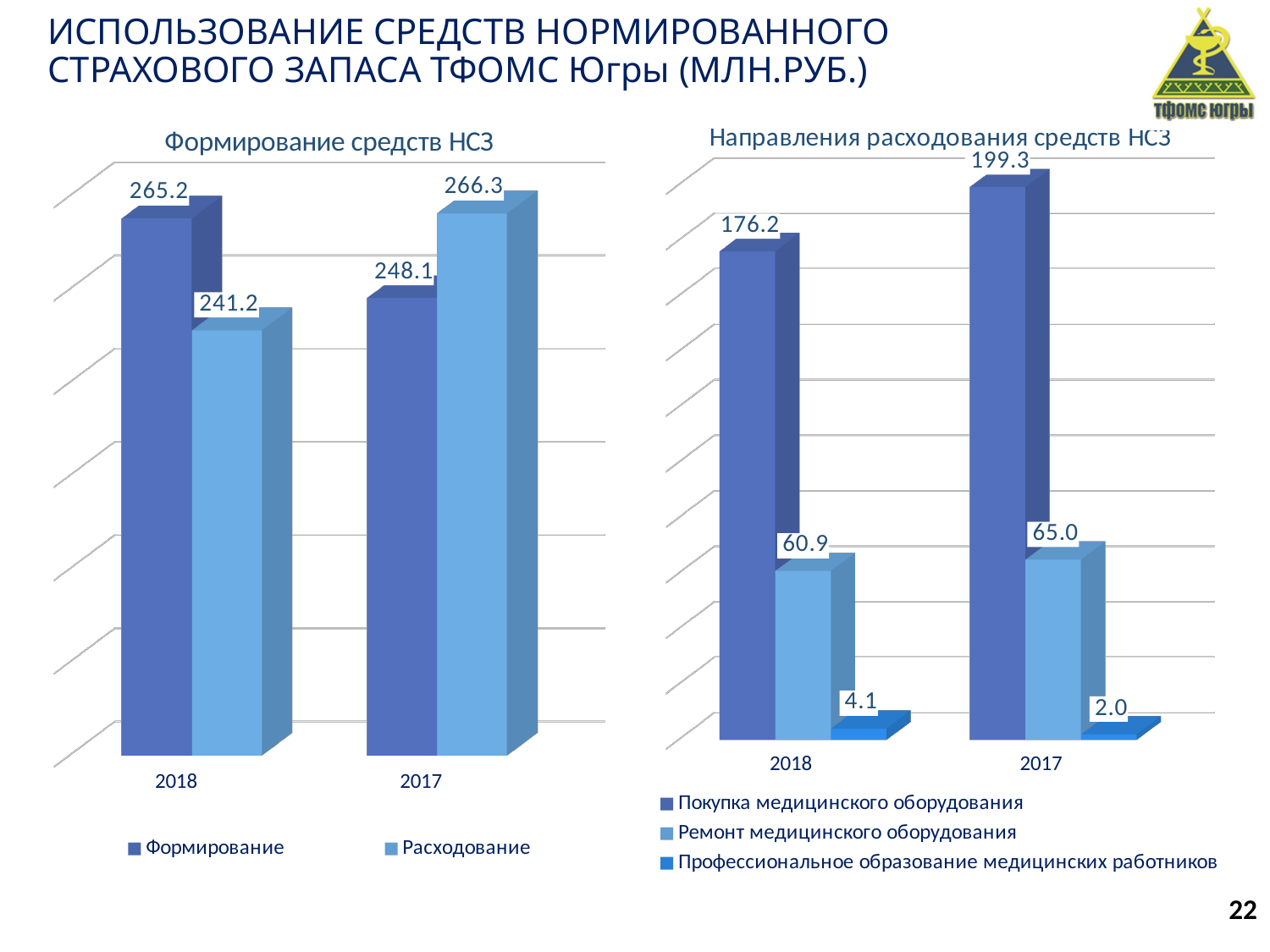
In the chart 'Направления расходования средств НСЗ', which series has the lowest value in 2017? Профессиональное образование медицинских работников In the chart 'Формирование средств НСЗ', how many series does the legend list? 2 In the chart 'Направления расходования средств НСЗ', what is the value of Профессиональное образование медицинских работников for 2018? 4.1 In the chart 'Формирование средств НСЗ', which is larger in 2017: Формирование or Расходование? Расходование In the chart 'Направления расходования средств НСЗ', what is the difference between Ремонт медицинского оборудования in 2017 and 2018? 4.1 In the chart 'Формирование средств НСЗ', what is the value of Формирование for 2018? 265.2 In the chart 'Направления расходования средств НСЗ', what is the value of Покупка медицинского оборудования for 2017? 199.3 In the chart 'Направления расходования средств НСЗ', does Покупка медицинского оборудования rise or fall from 2018 to 2017? Rises What kind of chart is 'Формирование средств НСЗ'? Bar chart In the chart 'Направления расходования средств НСЗ', how many series does the legend list? 3 In the chart 'Формирование средств НСЗ', what is the value of Расходование for 2017? 266.3 In the chart 'Формирование средств НСЗ', what is the difference between Формирование and Расходование in 2018? 24.0